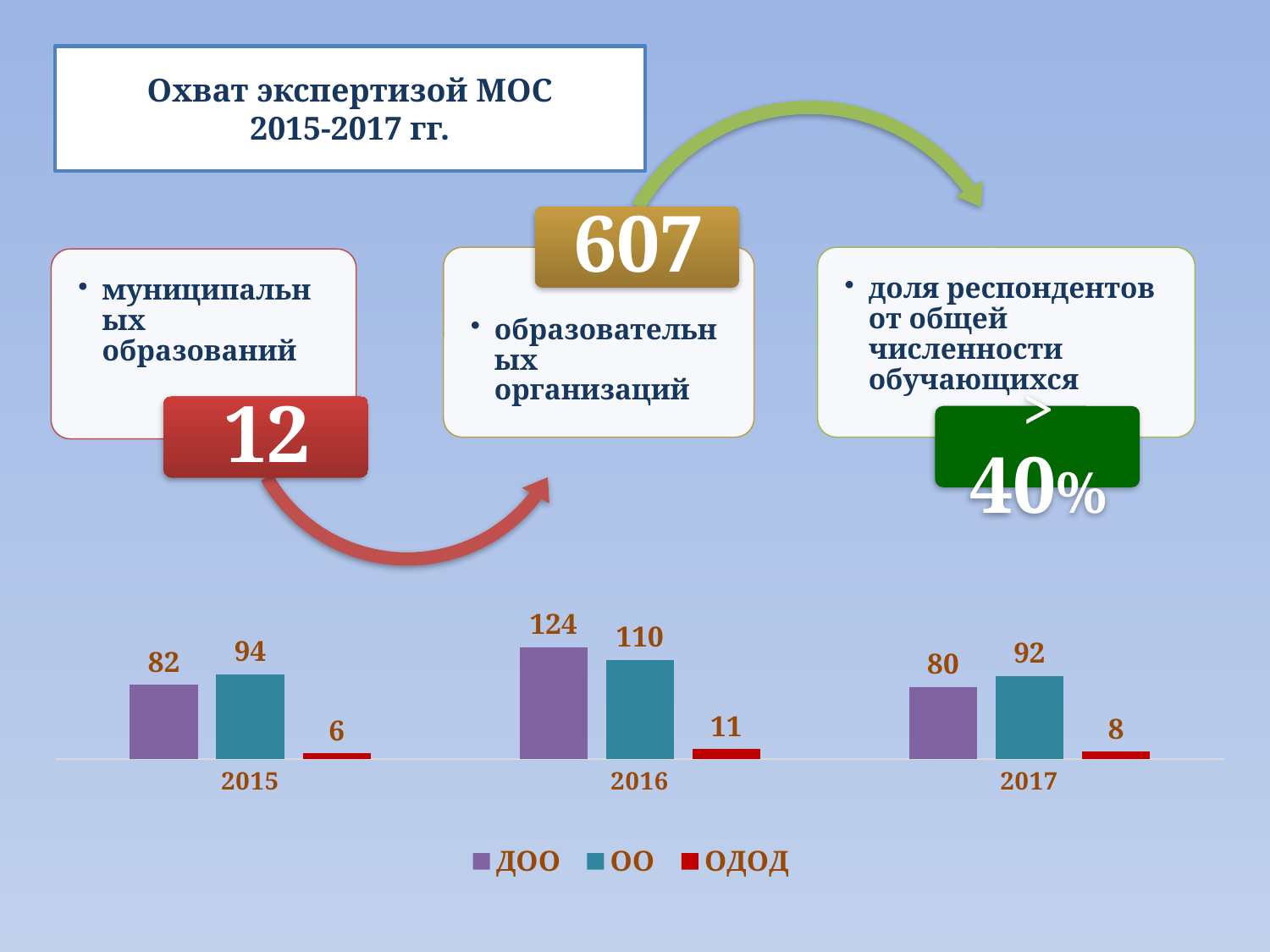
Which series is shown in red in the legend? ОДОД In which year is the ДОО value lowest? 2017 What is the value for ОО in 2015? 94 What kind of chart is shown? bar chart What is the difference between the ОДОД values in 2016 and 2015? 5 In which year is the ОО value highest? 2016 Which is larger in 2017, ДОО or ОО? ОО How many years are shown on the x axis? 3 What is the difference between the ОО and ДОО values in 2016? 14 What is the value for ДОО in 2016? 124 What is the value for ОДОД in 2017? 8 How many series does the legend list? 3